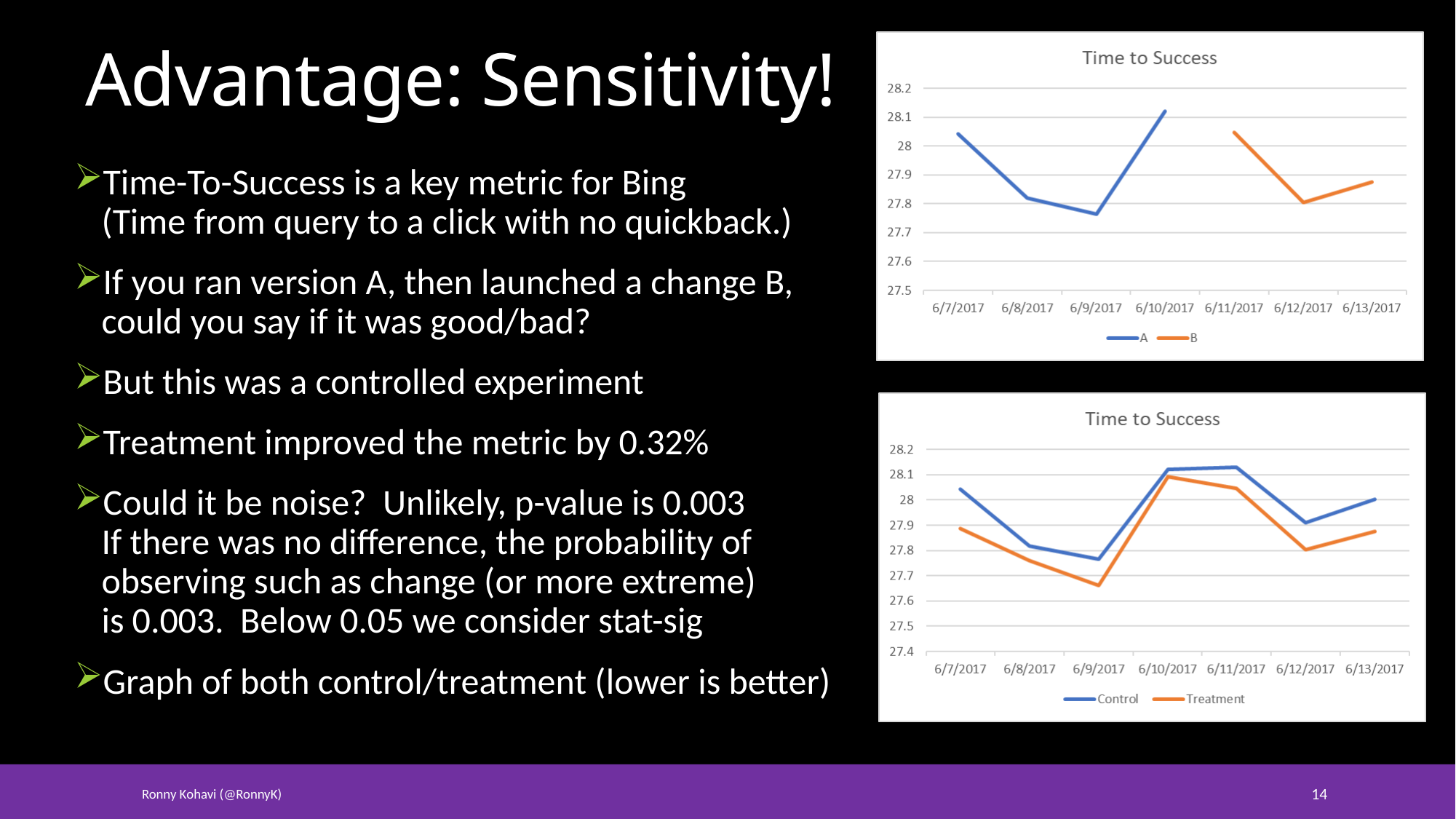
How many dates are shown on the x axis of the bottom chart? 7 In the top chart, is the value of series A on 6/9/2017 greater or less than 27.8? less What kind of chart is the top chart on the slide? Line chart In the top chart, is the value of series B on 6/11/2017 greater or less than 28? greater In the bottom chart, does the Control series rise or fall from 6/7/2017 to 6/9/2017? Fall In the bottom chart, on which date does the Treatment series reach its lowest value? 6/9/2017 In the top chart, on which date does series A reach its lowest value? 6/9/2017 What are the two series named in the legend of the top chart? A and B How many series does the legend of the bottom chart list? 2 In the top chart, on which date does series A reach its highest value? 6/10/2017 In the bottom chart, which series has the higher value on 6/7/2017, Control or Treatment? Control In the bottom chart, is the Treatment value on 6/9/2017 greater or less than 27.7? less